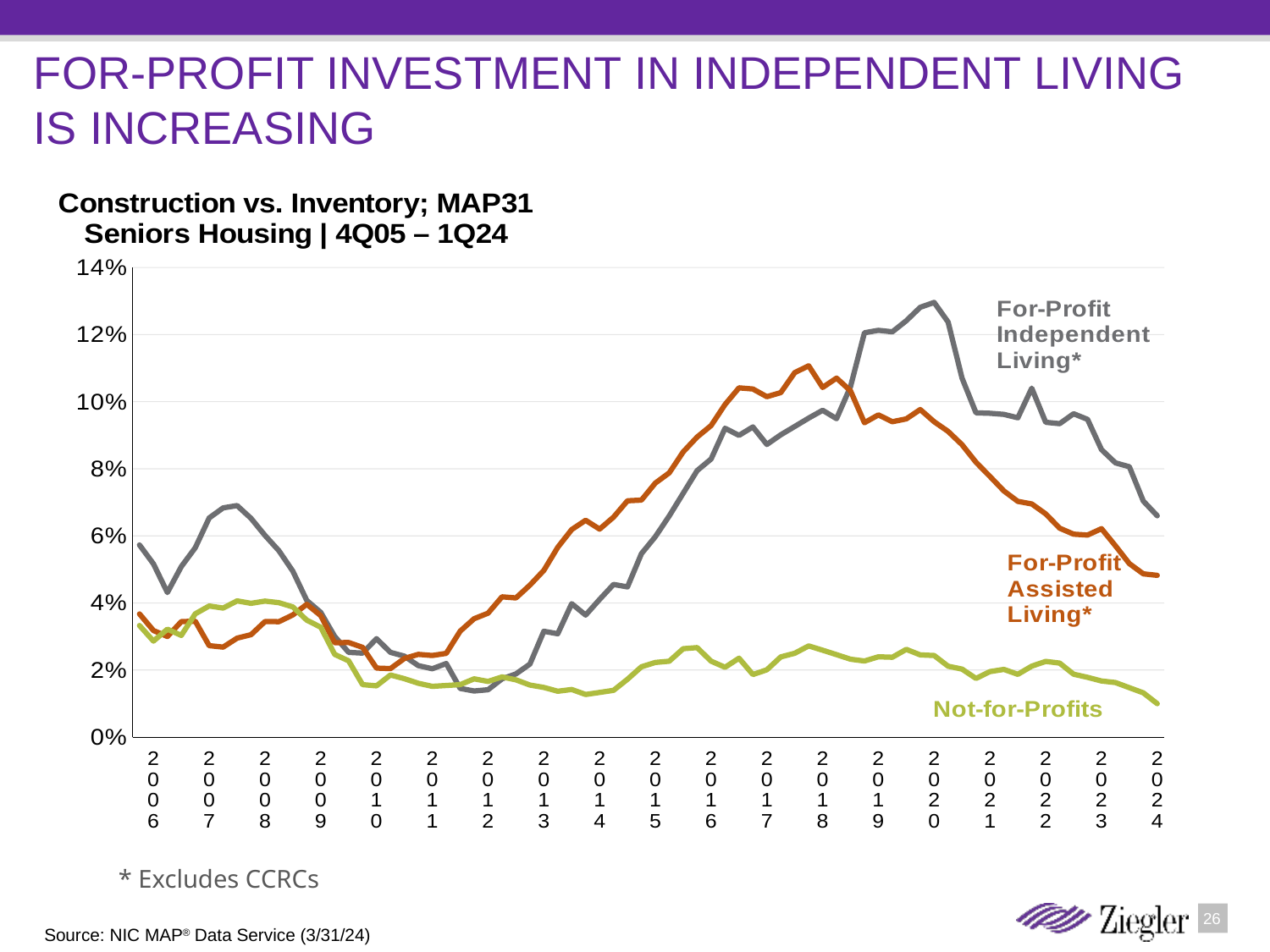
In 2018, which is higher: For-Profit Assisted Living or For-Profit Independent Living? For-Profit Assisted Living Does the For-Profit Independent Living line rise or fall from 2020 to 2024? fall How many year labels are shown along the x axis? 19 How many series are plotted on the chart? 3 In 2024, which is higher: For-Profit Independent Living or For-Profit Assisted Living? For-Profit Independent Living Is the value for Not-for-Profits in 2024 greater or less than 2%? less What kind of chart is shown on the slide? Line chart Is the peak value for For-Profit Independent Living around 2020 greater or less than 12%? greater What is the title of the chart? Construction vs. Inventory; MAP31 Seniors Housing | 4Q05 – 1Q24 Which series has the lowest value at the end of the chart in 2024? Not-for-Profits Is the value for For-Profit Assisted Living in 2018 greater or less than 10%? greater Which series reaches the highest value anywhere on the chart? For-Profit Independent Living*